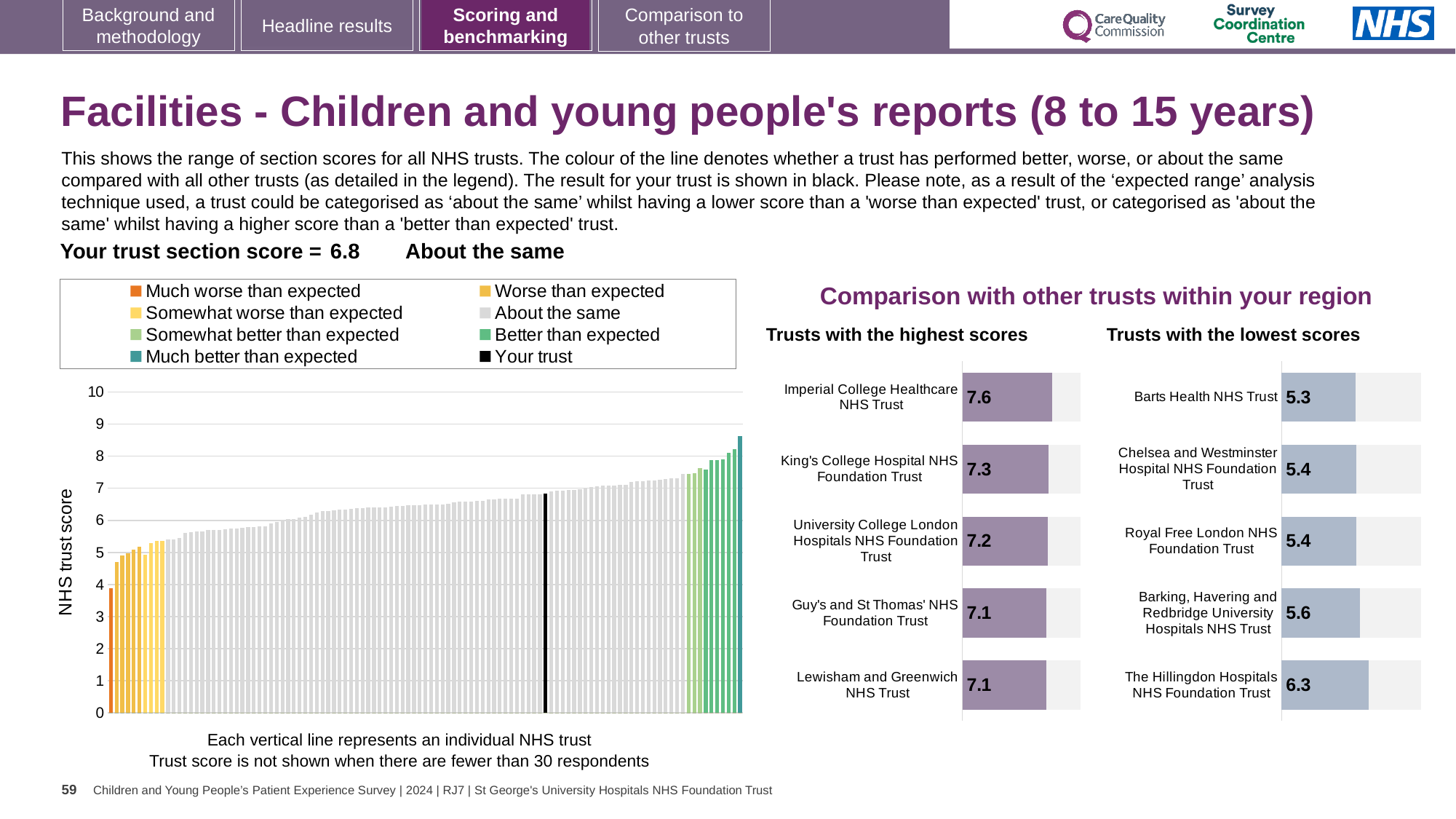
In the 'Trusts with the lowest scores' chart, which trust has the highest score? The Hillingdon Hospitals NHS Foundation Trust In the 'Trusts with the lowest scores' chart, what is the difference between the scores of The Hillingdon Hospitals NHS Foundation Trust and Barts Health NHS Trust? 1.0 In the 'Trusts with the highest scores' chart, what is the score for Imperial College Healthcare NHS Trust? 7.6 What kind of chart is the main 'NHS trust score' chart? bar chart In the main 'NHS trust score' chart, is the value of the tallest bar greater or less than 8? greater In the main 'NHS trust score' chart, how many entries does the legend list? 8 In the 'Trusts with the highest scores' chart, what is the score for King's College Hospital NHS Foundation Trust? 7.3 How many trusts are shown in the 'Trusts with the highest scores' chart? 5 In the 'Trusts with the lowest scores' chart, what is the score for Barts Health NHS Trust? 5.3 In the 'Trusts with the lowest scores' chart, what is the score for The Hillingdon Hospitals NHS Foundation Trust? 6.3 In the 'Trusts with the highest scores' chart, what is the difference between the scores of Imperial College Healthcare NHS Trust and King's College Hospital NHS Foundation Trust? 0.3 In the 'Trusts with the lowest scores' chart, which trust has the lowest score? Barts Health NHS Trust